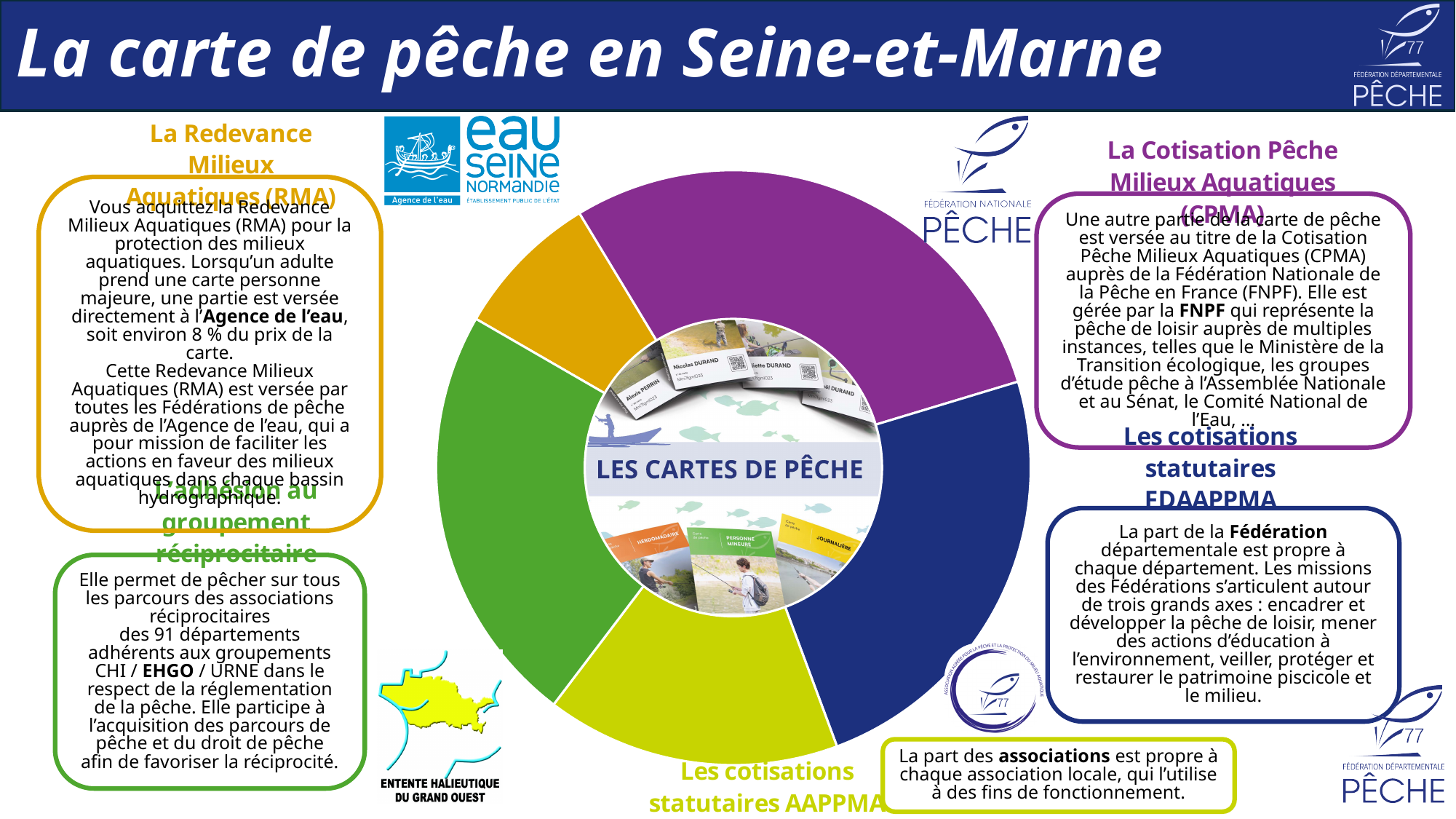
Which is larger in the doughnut chart: the purple segment or the gold segment? The purple segment Which segment of the doughnut chart is the smallest? The gold/yellow segment (Redevance Milieux Aquatiques, RMA) What text is written in the centre of the doughnut chart? LES CARTES DE PÊCHE Which is larger in the doughnut chart: the dark blue segment or the yellow-green segment? The dark blue segment What kind of chart is shown in the centre of the slide? Doughnut (pie) chart Does the doughnut chart display any numeric data labels on its segments? No How many segments does the doughnut chart have? 5